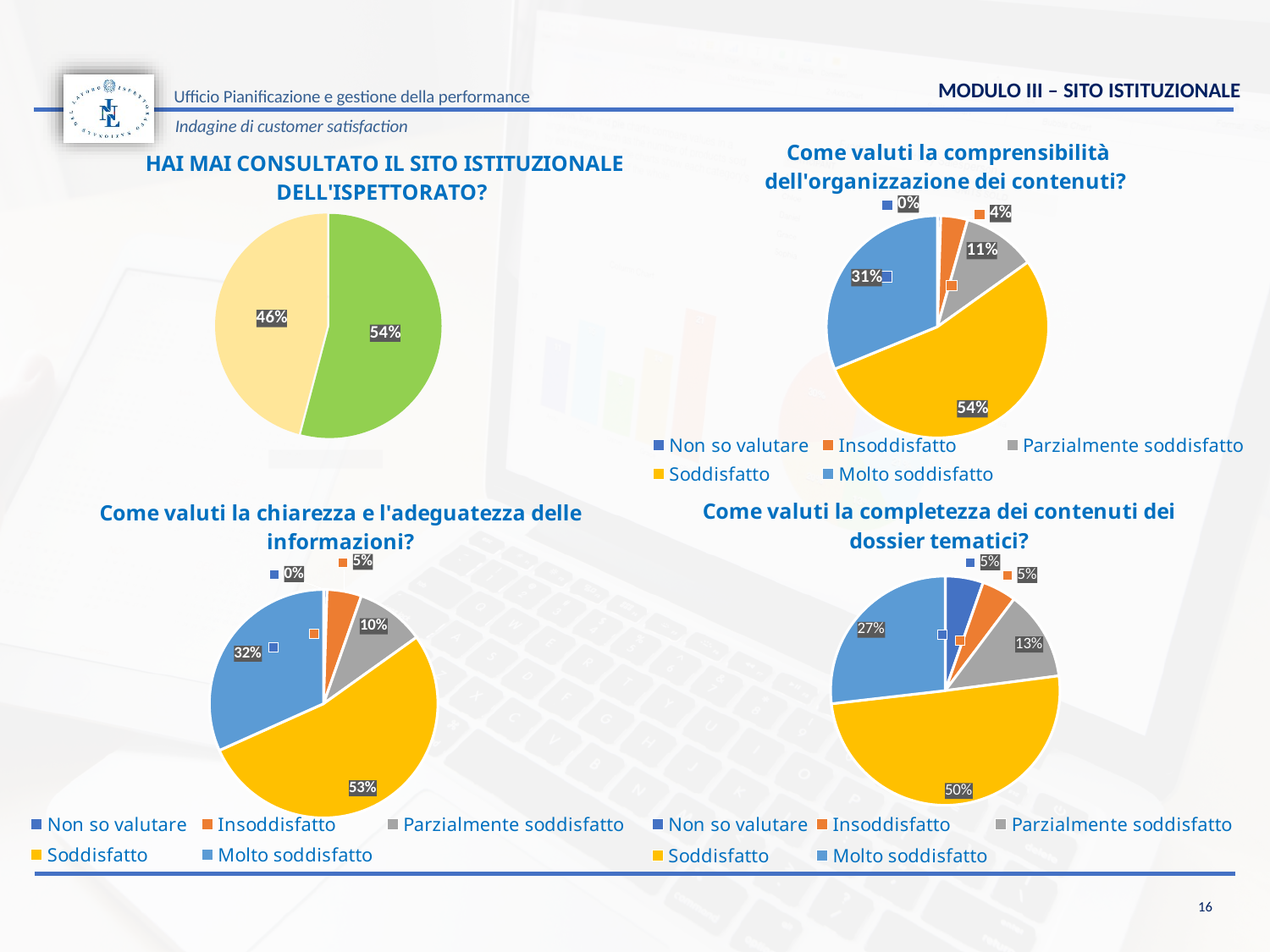
In the chart 'Come valuti la completezza dei contenuti dei dossier tematici?', what share is labelled for Molto soddisfatto? 27% How many slices does the chart 'HAI MAI CONSULTATO IL SITO ISTITUZIONALE DELL'ISPETTORATO?' have? 2 In the chart 'Come valuti la comprensibilità dell'organizzazione dei contenuti?', what share is labelled for Molto soddisfatto? 31% In the chart 'Come valuti la comprensibilità dell'organizzazione dei contenuti?', what share is labelled for Soddisfatto? 54% In the chart 'Come valuti la chiarezza e l'adeguatezza delle informazioni?', what is the difference between the Soddisfatto and Molto soddisfatto shares? 21% In the chart 'Come valuti la chiarezza e l'adeguatezza delle informazioni?', which category has the largest share? Soddisfatto In the chart 'Come valuti la comprensibilità dell'organizzazione dei contenuti?', which category has the smallest share? Non so valutare In the chart 'HAI MAI CONSULTATO IL SITO ISTITUZIONALE DELL'ISPETTORATO?', what is the share of the largest slice? 54% How many entries does the legend of the chart 'Come valuti la completezza dei contenuti dei dossier tematici?' list? 5 In the chart 'Come valuti la completezza dei contenuti dei dossier tematici?', which is larger: the share for Soddisfatto or the share for Molto soddisfatto? Soddisfatto